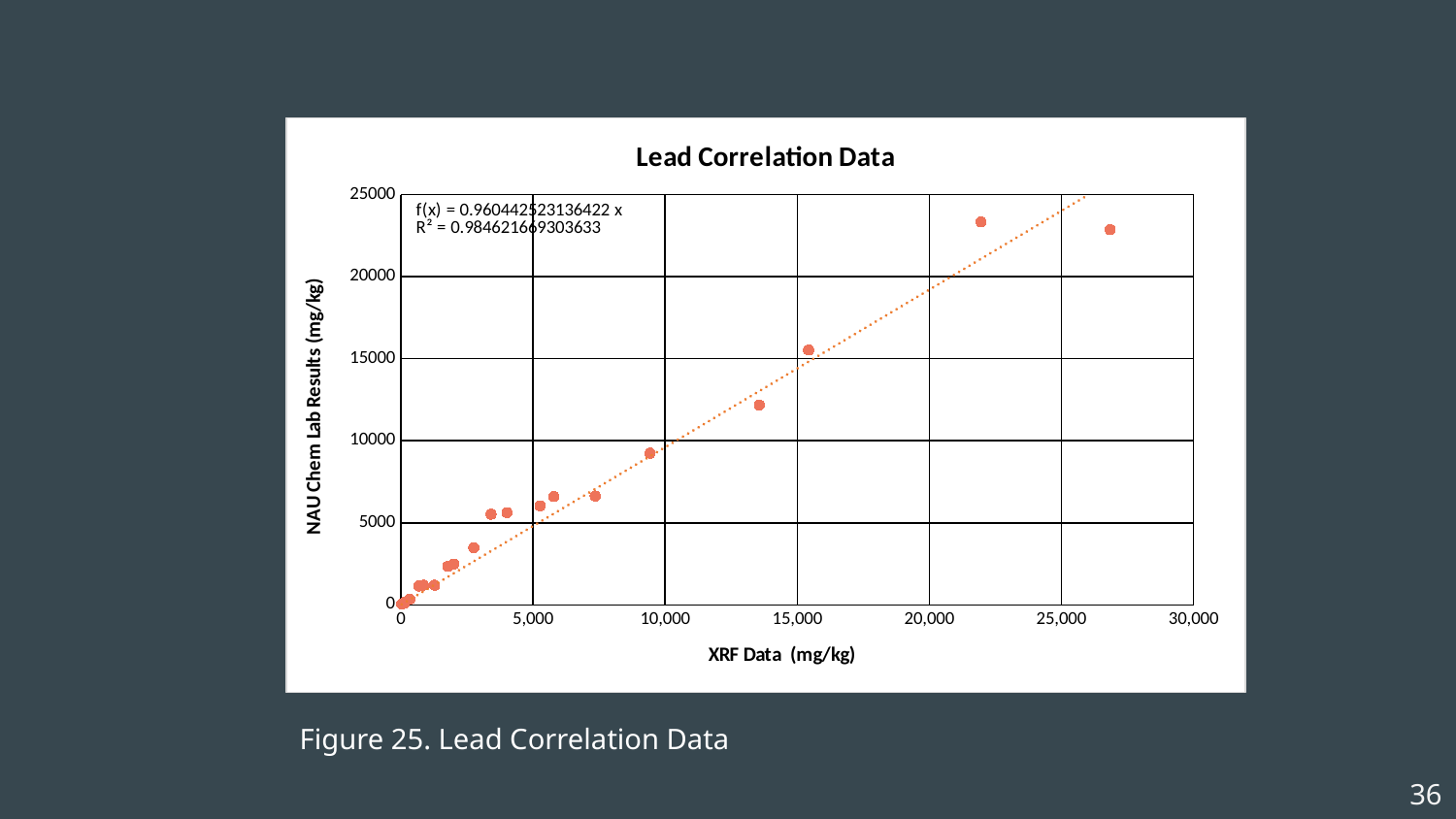
What is the label of the x axis of the chart? XRF Data (mg/kg) What trendline equation f(x) is printed on the chart? f(x) = 0.960442523136422 x What is the highest tick value shown on the y axis? 25000 What is the highest tick value shown on the x axis? 30,000 Do the NAU Chem Lab Results generally rise or fall as the XRF Data values increase along the x axis? rise Is the NAU Chem Lab Result for the point with the highest XRF value greater or less than 20000? greater What R² value is printed on the chart? 0.984621669303633 What is the title of the chart? Lead Correlation Data What kind of chart is shown on the slide? scatter chart Is the NAU Chem Lab Result for the point with XRF Data between 10,000 and 15,000 greater or less than 15000? less Is the XRF value of the rightmost point greater or less than 25,000? greater